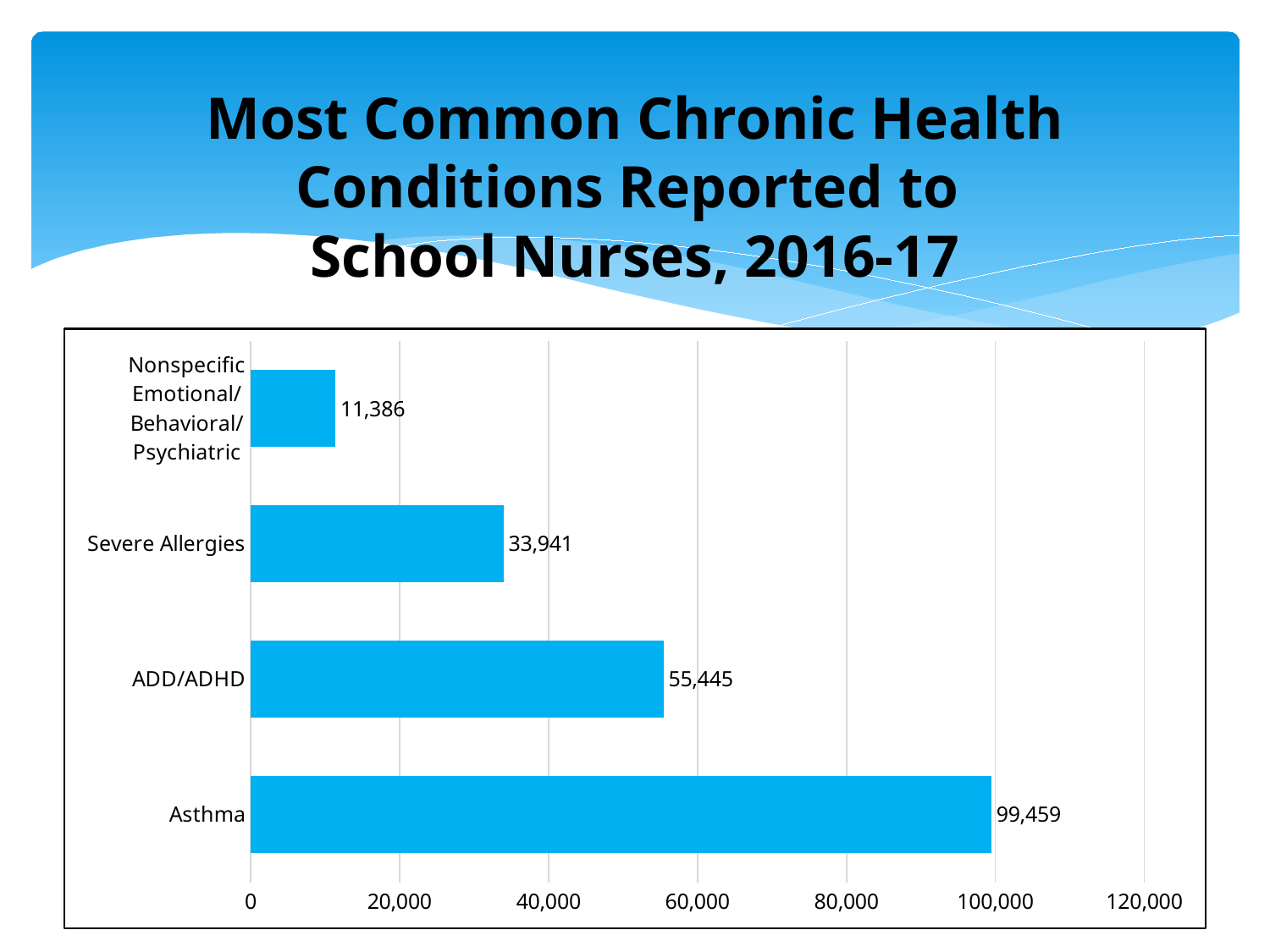
What value is shown for Asthma? 99,459 What is the difference between the values for Severe Allergies and Nonspecific Emotional/Behavioral/Psychiatric? 22,555 What value is shown for Severe Allergies? 33,941 How many conditions are shown in the chart? 4 What kind of chart is shown on the slide? bar chart What value is shown for Nonspecific Emotional/Behavioral/Psychiatric? 11,386 What is the difference between the values for Asthma and ADD/ADHD? 44,014 What value is shown for ADD/ADHD? 55,445 Is the value for Severe Allergies greater or less than 40,000? less Which condition has the highest value? Asthma Which is larger, the value for ADD/ADHD or the value for Severe Allergies? ADD/ADHD Which condition has the lowest value? Nonspecific Emotional/Behavioral/Psychiatric